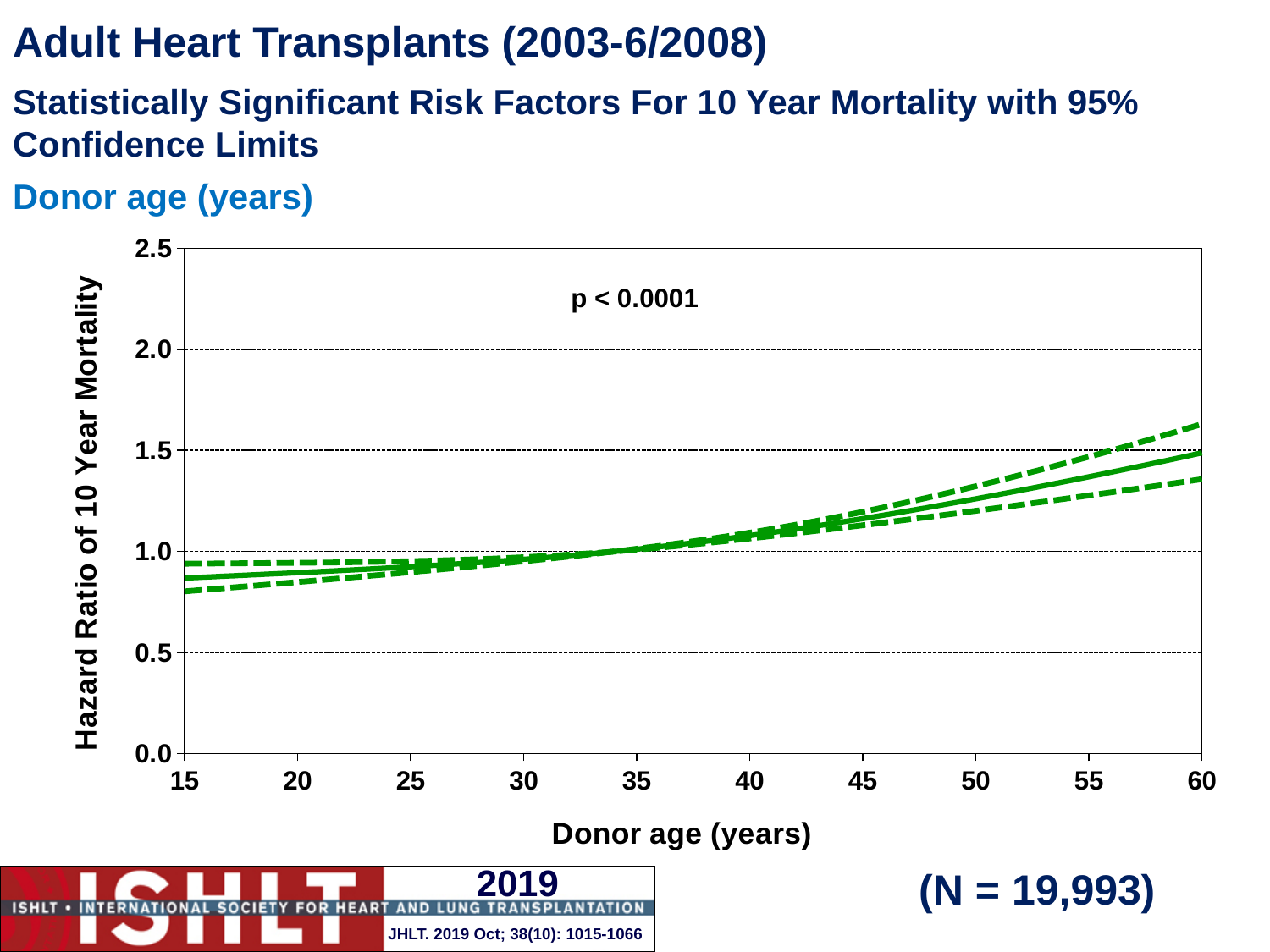
Is the lower 95% confidence limit (lower dashed line) at a donor age of 60 years greater or less than 1.5? less Is the upper 95% confidence limit (upper dashed line) at a donor age of 60 years greater or less than 1.5? greater What p-value is printed on the chart? p < 0.0001 Is the hazard ratio (solid line) at a donor age of 45 years greater or less than 1.0? greater How many lines are plotted on the chart? 3 What sample size (N) is shown on the slide? N = 19,993 What kind of chart is shown on the slide? Line chart Does the hazard ratio of 10 year mortality rise or fall as donor age increases from 15 to 60 years? Rise How many tick labels are shown on the donor age (x) axis? 10